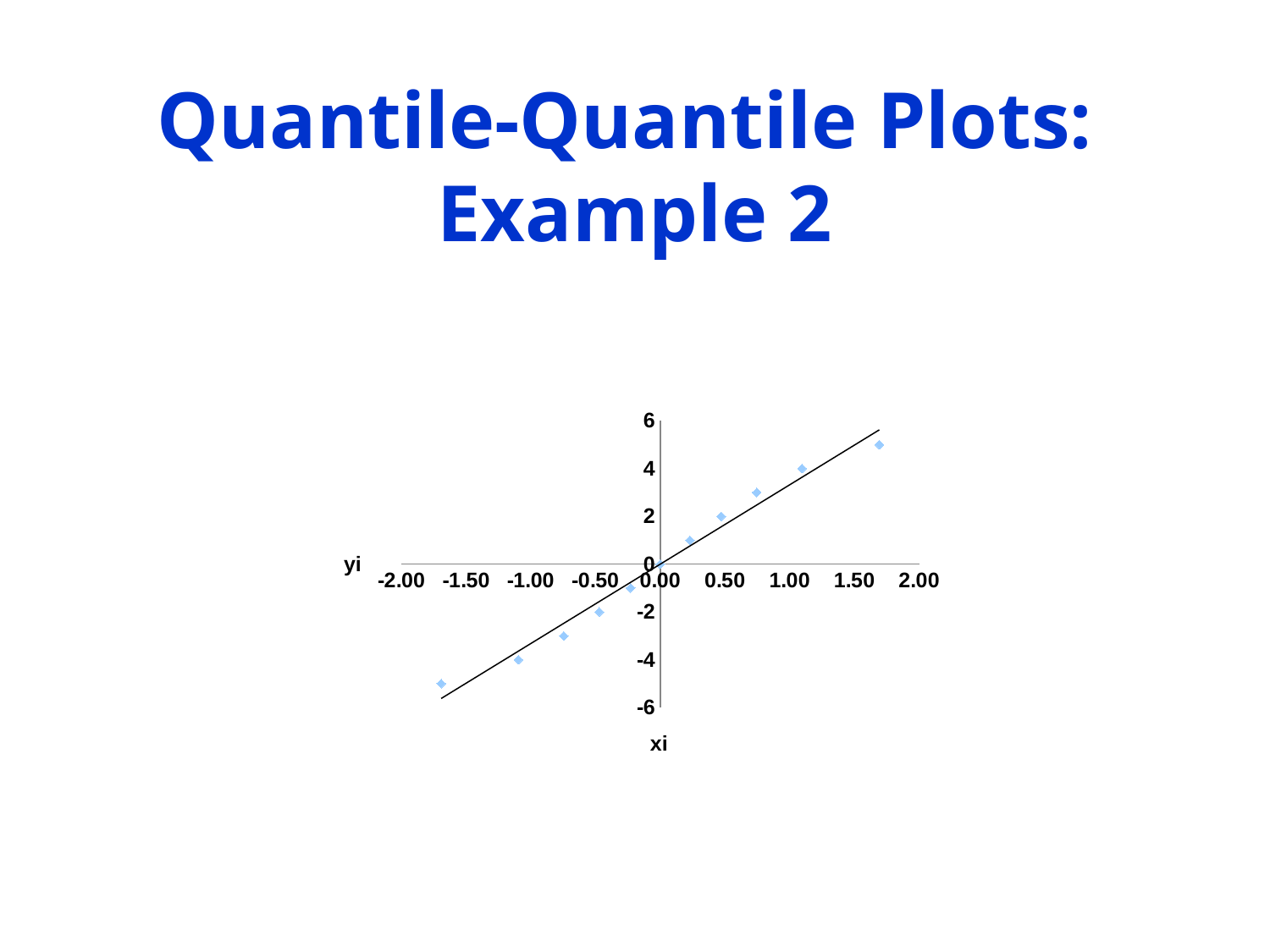
What is the label on the horizontal axis of the chart? xi How many data points are plotted in the chart? 11 What is the maximum value shown on the vertical axis? 6 Which point has the highest yi value, the leftmost point or the rightmost point? the rightmost point Is the yi value of the leftmost point greater or less than -4? less What kind of chart is shown on the slide? scatter plot Is the yi value of the rightmost point greater or less than 4? greater What is the label on the vertical axis of the chart? yi What is the minimum value shown on the horizontal axis? -2.00 Do the plotted values rise or fall as xi increases along the x axis? rise Is the yi value of the point nearest xi = -1.00 greater or less than -2? less